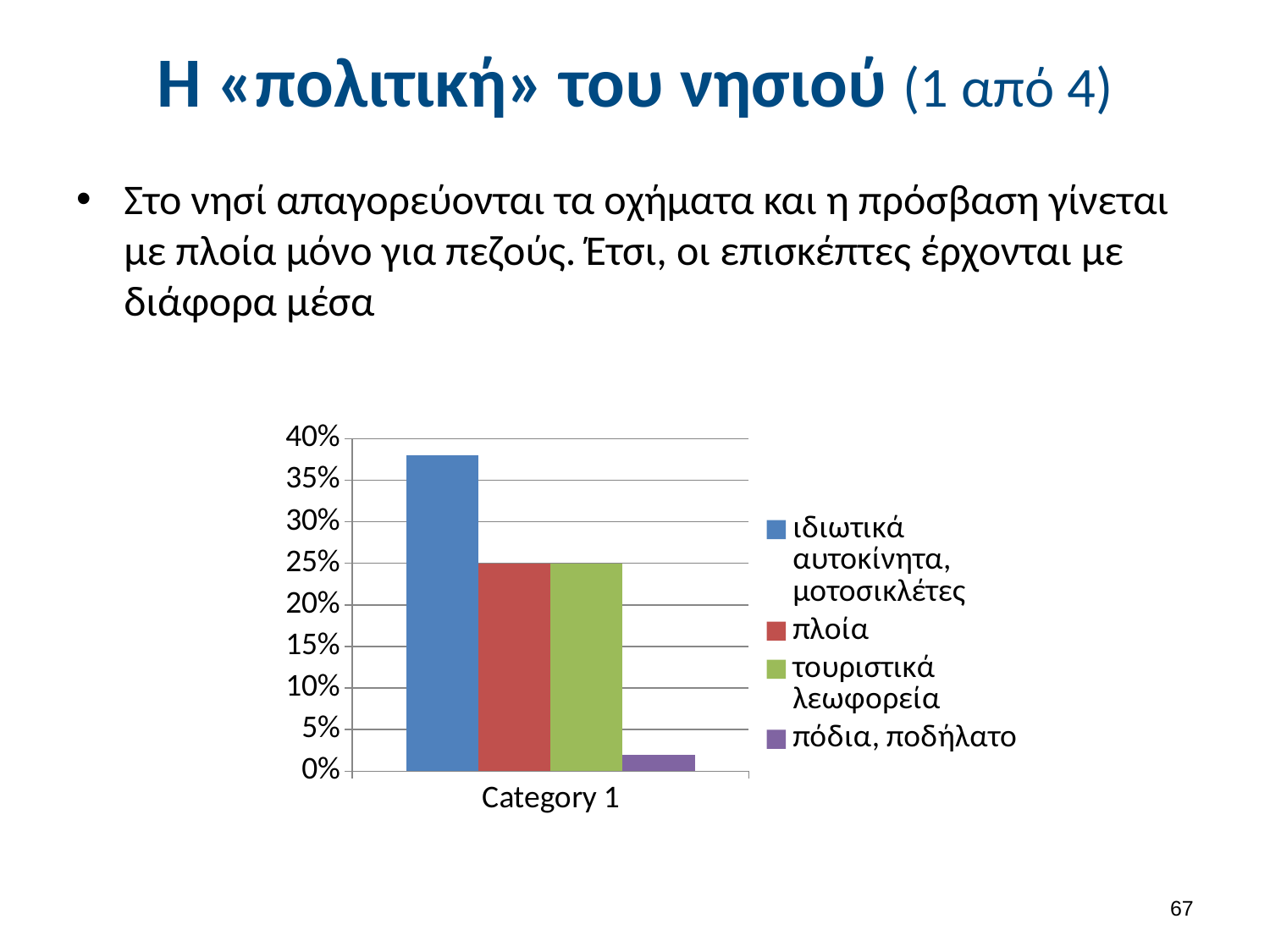
Which series has the highest bar in the chart? ιδιωτικά αυτοκίνητα, μοτοσικλέτες What colour is the bar for πλοία in the chart? red Is the value for πόδια, ποδήλατο greater or less than 5%? less What kind of chart is shown on the slide? bar chart What is the label shown on the x axis of the chart? Category 1 How many categories are shown on the x axis of the chart? 1 What is the value for πλοία in the chart? 25% Is the value for ιδιωτικά αυτοκίνητα, μοτοσικλέτες greater or less than 35%? greater Which is larger, the value for ιδιωτικά αυτοκίνητα, μοτοσικλέτες or the value for πλοία? ιδιωτικά αυτοκίνητα, μοτοσικλέτες Which series has the lowest bar in the chart? πόδια, ποδήλατο What is the value for τουριστικά λεωφορεία in the chart? 25% How many series does the chart's legend list? 4